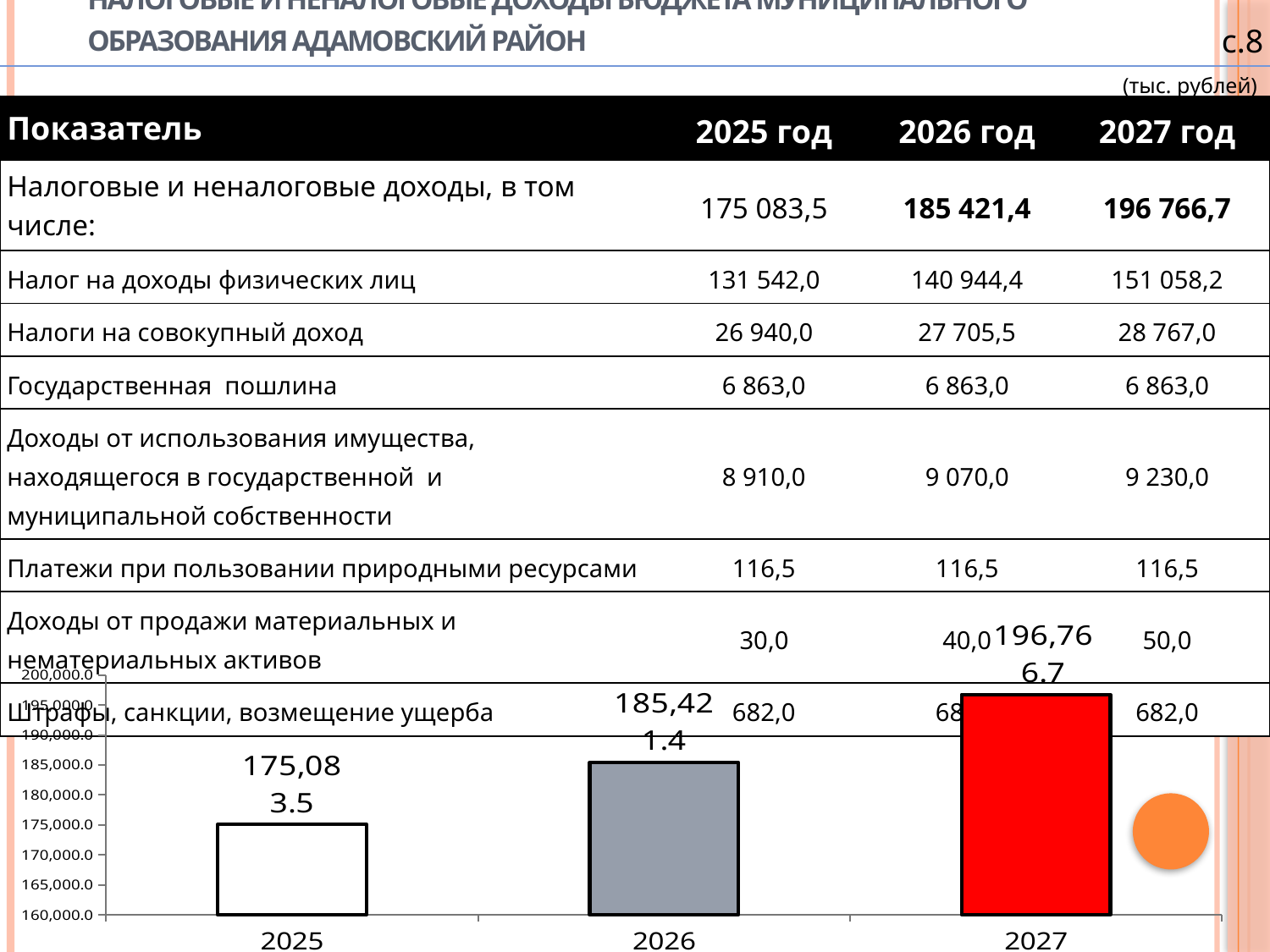
What is the value shown on the bar for 2027 in the chart? 196,766.7 What kind of chart is shown at the bottom of the slide? bar chart What is the difference between the 2027 and 2025 bar values in the chart? 21,683.2 What is the value shown on the bar for 2026 in the chart? 185,421.4 Do the bar values rise or fall from 2025 to 2027 in the chart? rise Is the value for 2026 in the chart greater or less than 180,000.0? greater Which year has the lowest bar in the chart? 2025 How many bars does the chart at the bottom of the slide have? 3 Which is larger in the chart, the bar for 2026 or the bar for 2025? 2026 What is the value shown on the bar for 2025 in the chart? 175,083.5 Which year has the highest bar in the chart? 2027 What colour is the bar for 2027 in the chart? red